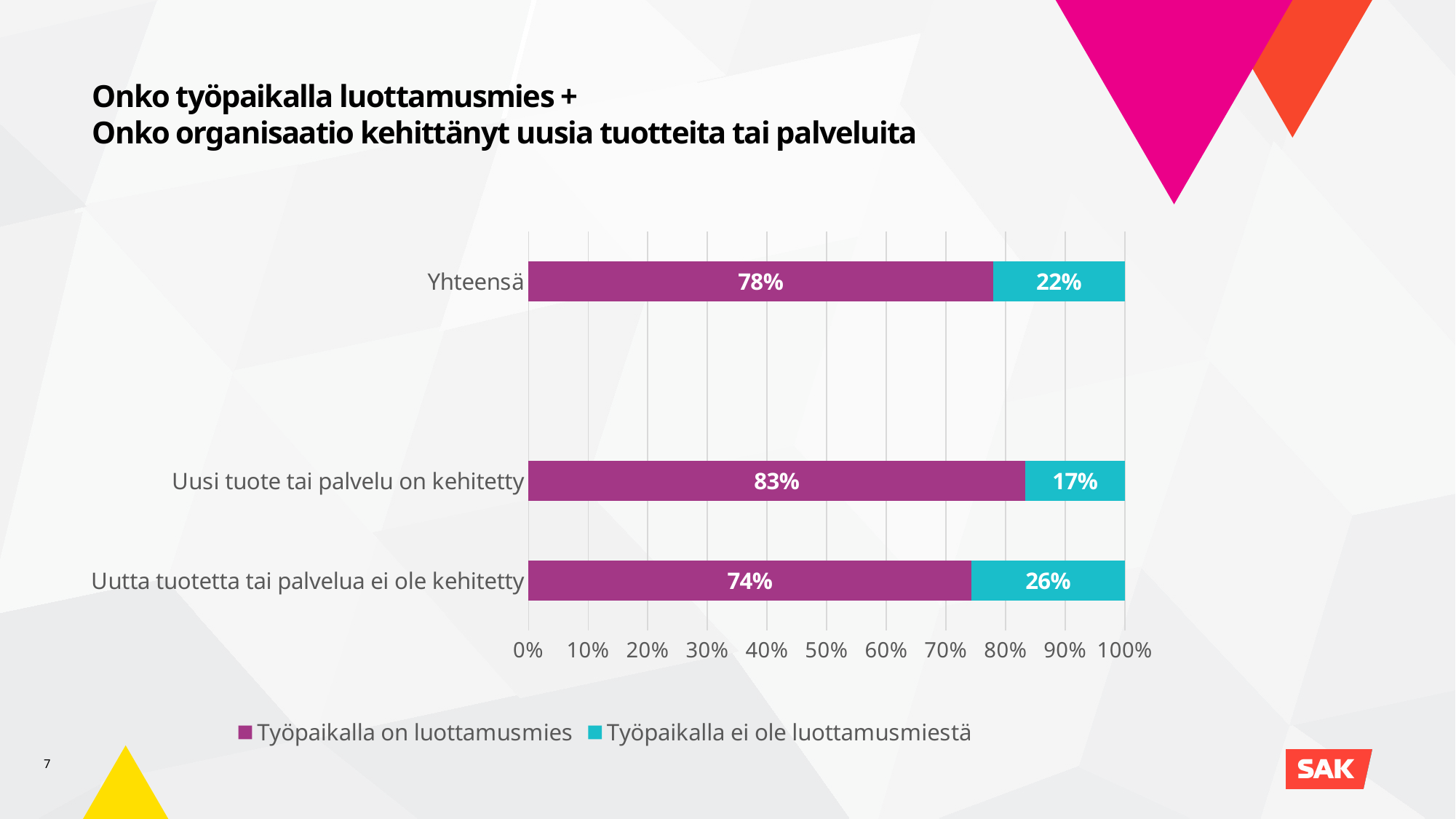
Which category has the highest value for "Työpaikalla on luottamusmies"? Uusi tuote tai palvelu on kehitetty What is the difference between the "Työpaikalla on luottamusmies" values for "Uusi tuote tai palvelu on kehitetty" and "Uutta tuotetta tai palvelua ei ole kehitetty"? 9% What kind of chart is shown on the slide? Stacked bar chart What is the value for "Työpaikalla on luottamusmies" in the "Uutta tuotetta tai palvelua ei ole kehitetty" category? 74% What is the total of the stacked bar for "Yhteensä"? 100% What is the value for "Työpaikalla ei ole luottamusmiestä" in the "Uusi tuote tai palvelu on kehitetty" category? 17% What is the value for "Työpaikalla on luottamusmies" in the "Yhteensä" category? 78% Which category has the lowest value for "Työpaikalla ei ole luottamusmiestä"? Uusi tuote tai palvelu on kehitetty How many categories are shown on the chart? 3 How many series does the legend list? 2 Which is larger: the "Työpaikalla ei ole luottamusmiestä" value for "Yhteensä" or for "Uutta tuotetta tai palvelua ei ole kehitetty"? Uutta tuotetta tai palvelua ei ole kehitetty Which colour represents "Työpaikalla ei ole luottamusmiestä" in the legend? Cyan (turquoise)